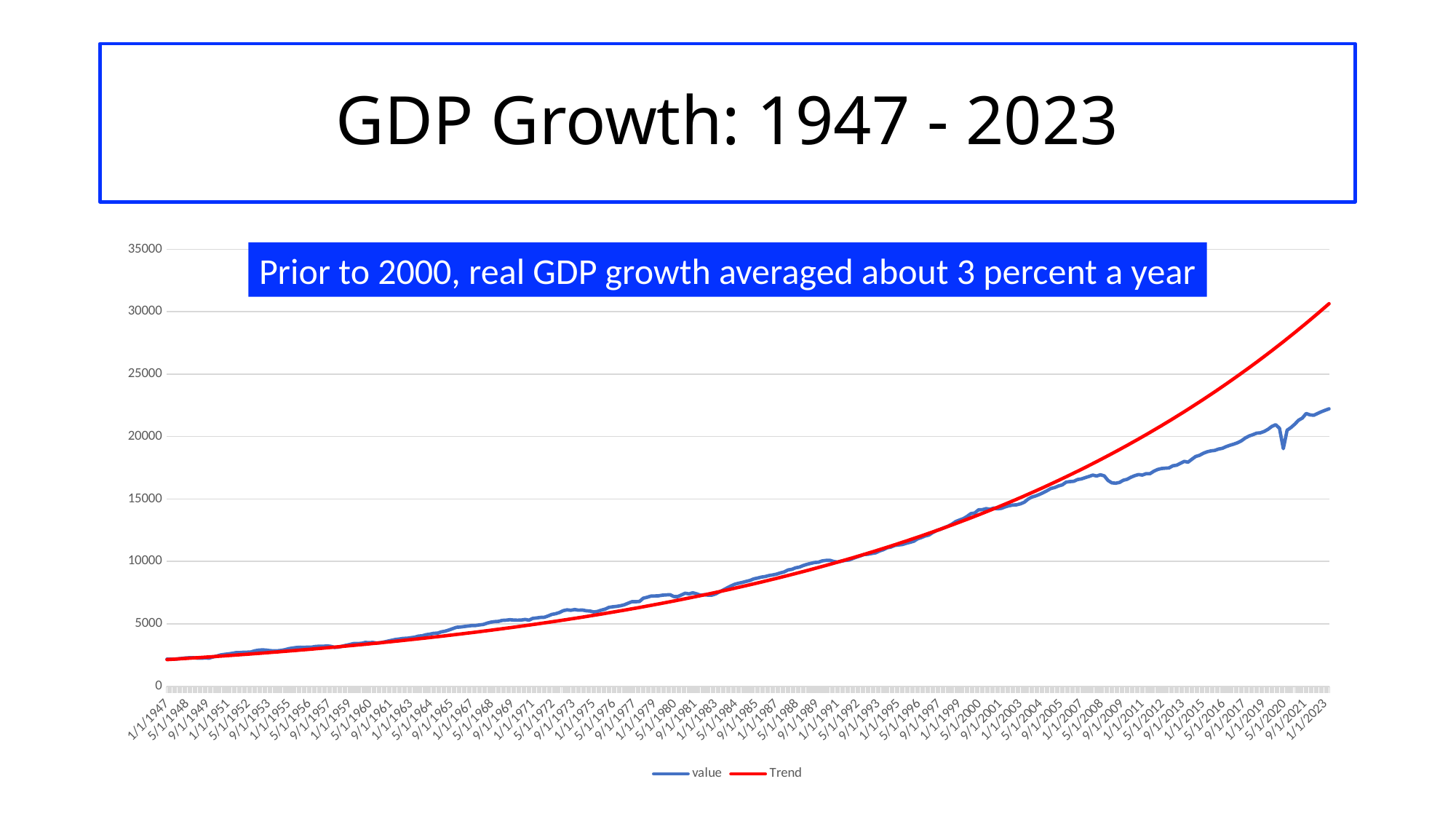
At 1/1/2023, which series is larger, 'value' or 'Trend'? Trend Which series reaches the highest point on the chart? Trend Is the 'value' series at 1/1/1991 greater or less than 15000? less What are the two series named in the legend? value and Trend How many series does the legend list? 2 Do the values of the 'value' series generally rise or fall from 1947 to 2023? Rise Is the 'value' series at 1/1/2023 greater or less than 20000? greater What is the title of the slide containing the chart? GDP Growth: 1947 - 2023 Is the 'value' series at 1/1/1947 greater or less than 5000? less What kind of chart is shown on the slide? Line chart